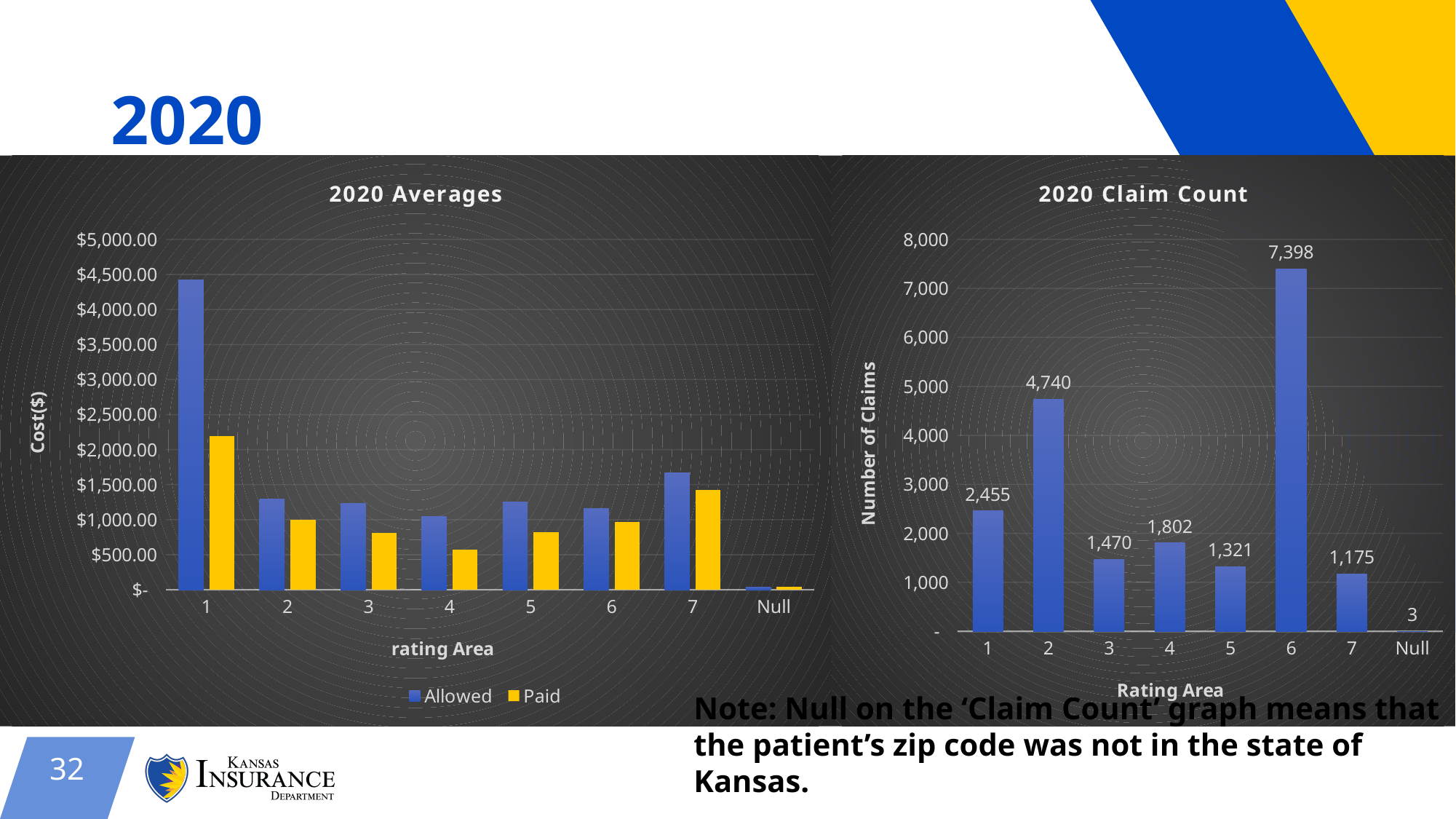
In the '2020 Claim Count' chart, which rating area has the highest number of claims? 6 In the '2020 Claim Count' chart, which labelled rating area (excluding Null) has the lowest number of claims? 7 In the '2020 Claim Count' chart, what is the difference in claims between rating area 6 and rating area 2? 2,658 How many rating area categories are shown on the x axis of the '2020 Claim Count' chart? 8 How many series does the legend of the '2020 Averages' chart list? 2 In the '2020 Claim Count' chart, what is the number of claims for the Null rating area? 3 In the '2020 Claim Count' chart, what is the number of claims for rating area 6? 7,398 In the '2020 Averages' chart, is the Paid value for rating area 4 greater or less than $1,000.00? less In the '2020 Averages' chart, is the Allowed value for rating area 1 greater or less than $4,000.00? greater What type of chart is the '2020 Averages' chart? Bar chart In the '2020 Claim Count' chart, which has more claims, rating area 4 or rating area 5? 4 In the '2020 Claim Count' chart, what is the number of claims for rating area 2? 4,740